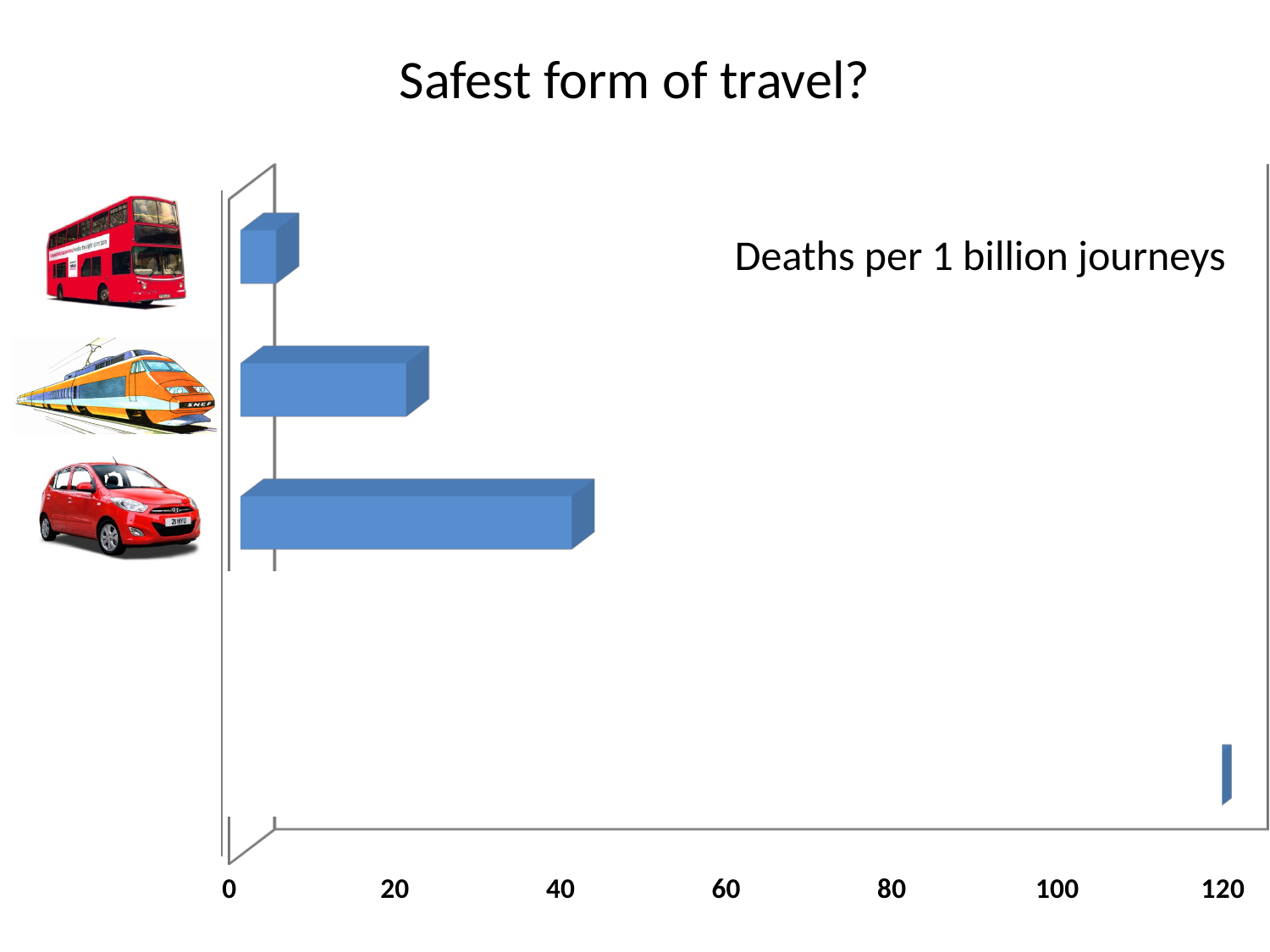
Is the value of the third bar (next to the car picture) greater or less than 20? greater Is the value of the third bar (next to the car picture) greater or less than 60? less What kind of chart is shown on the slide? bar chart What text label appears inside the chart area describing what is measured? Deaths per 1 billion journeys Is the value of the second bar (next to the train picture) greater or less than 40? less Which is larger, the top bar (bus) or the third bar (car)? the third bar (car) Which is larger, the second bar (train) or the third bar (car)? the third bar (car) Do the bar values increase or decrease going from the top bar down to the third bar? increase Which is larger, the top bar (bus) or the second bar (train)? the second bar (train) What is the highest value shown on the horizontal axis? 120